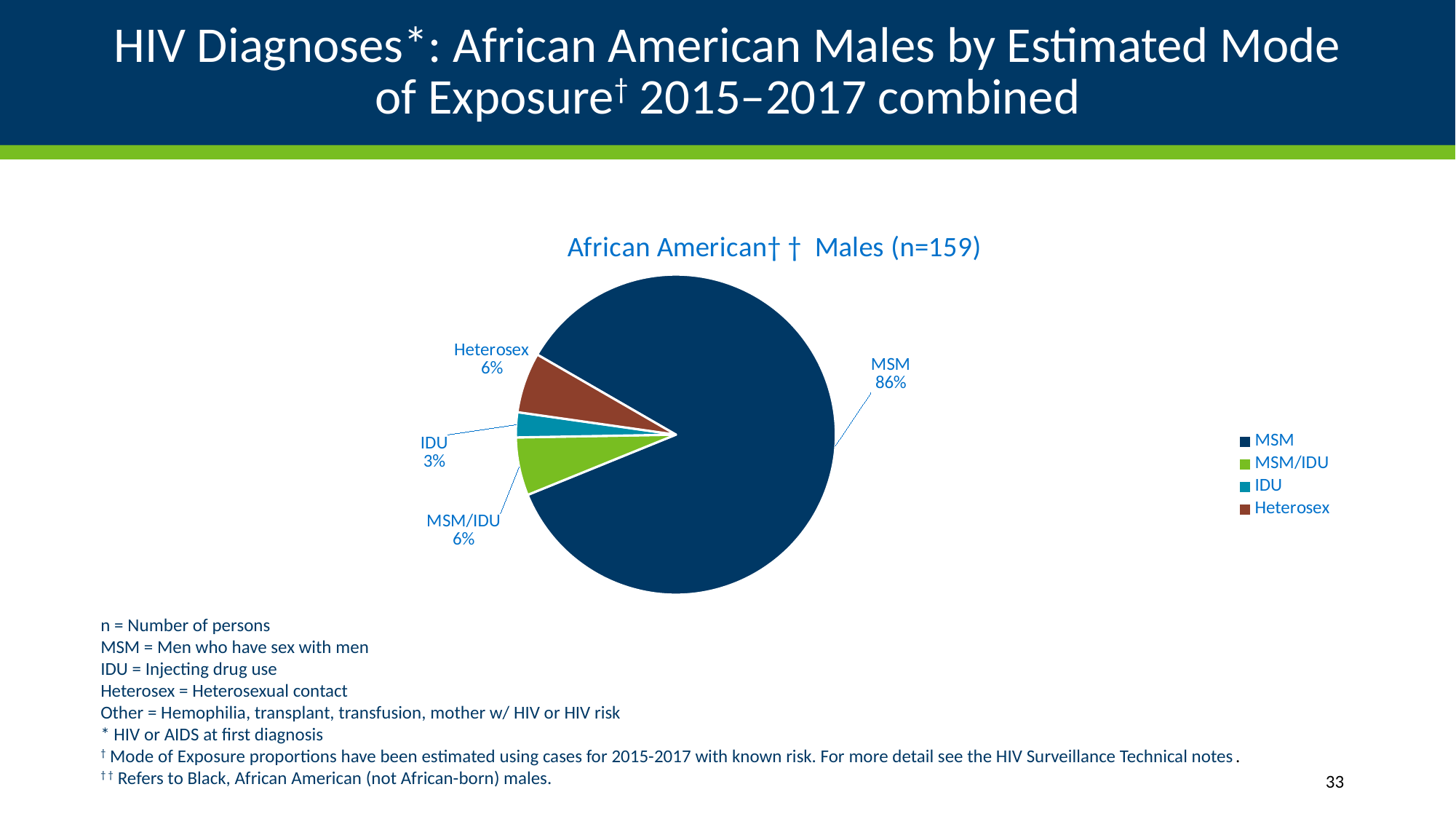
What percentage of the pie chart is MSM? 86% What is the value of n shown in the chart title? 159 Which mode of exposure has the largest share of the pie chart? MSM Which is larger, the share for MSM/IDU or the share for IDU? MSM/IDU What percentage of the pie chart is IDU? 3% How many entries does the legend list? 4 Which mode of exposure has the smallest share of the pie chart? IDU What percentage of the pie chart is MSM/IDU? 6% What percentage of the pie chart is Heterosex? 6% How many slices does the pie chart have? 4 What is the difference in percentage points between MSM and Heterosex? 80 What kind of chart is shown on the slide? Pie chart